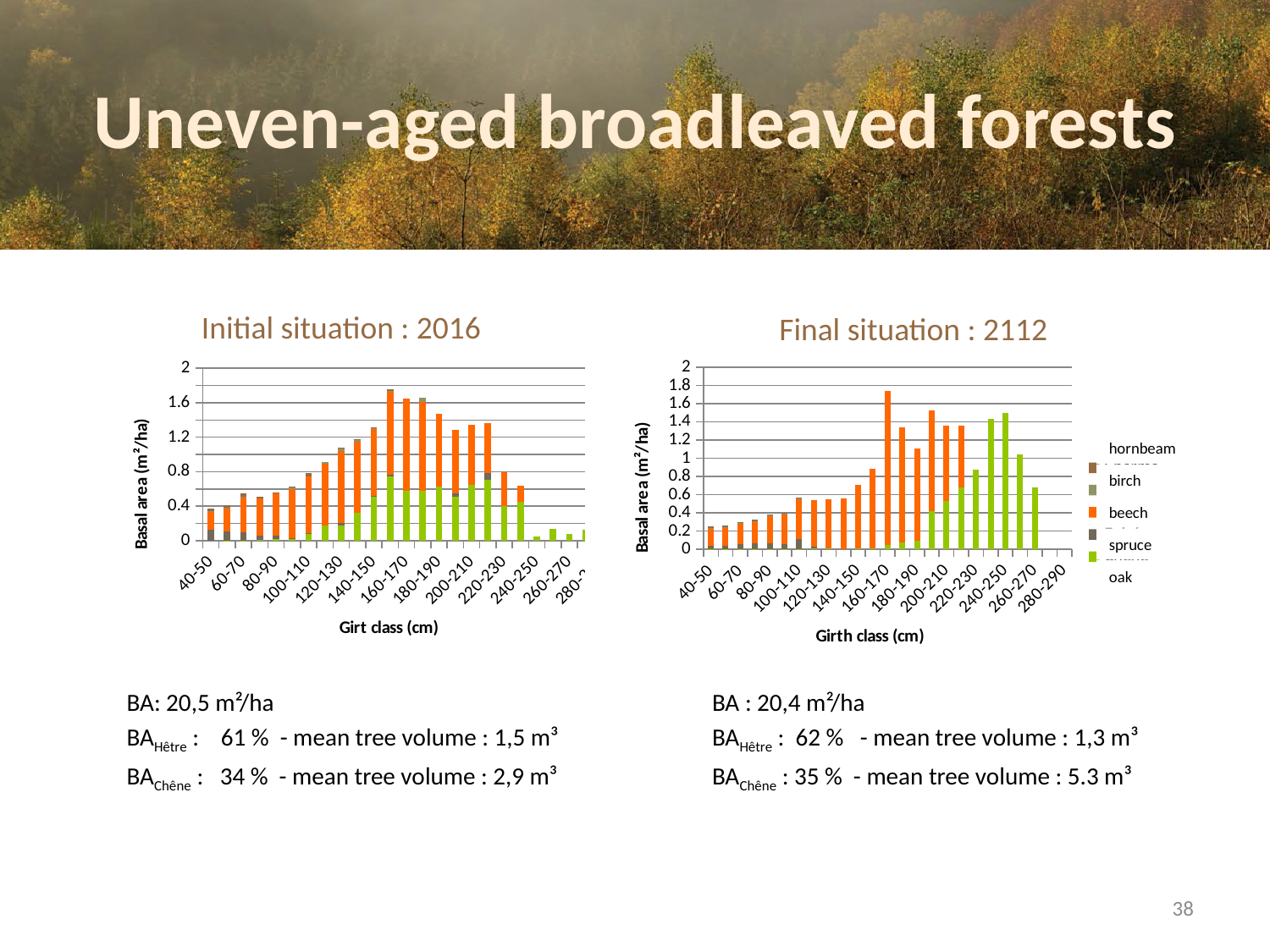
What kind of chart is the 'Initial situation : 2016' chart? bar chart In the 'Final situation : 2112' chart, is the total value for the 240-250 girth class greater or less than 1.2? greater How many series does the legend of the 'Final situation : 2112' chart list? 5 In the 'Initial situation : 2016' chart, is the total value for the 160-170 girth class greater or less than 1.2? greater In the 'Initial situation : 2016' chart, is the total value for the 260-270 girth class greater or less than 0.4? less What is the y-axis label of the 'Final situation : 2112' chart? Basal area (m²/ha) In the 'Final situation : 2112' chart, which girth class has the highest total basal area? 160-170 In the 'Initial situation : 2016' chart, do the total values rise or fall from the 40-50 girth class to the 160-170 girth class? rise In the 'Final situation : 2112' chart, which has the larger total basal area, the 160-170 girth class or the 280-290 girth class? 160-170 In the 'Initial situation : 2016' chart, which has the larger total basal area, the 40-50 girth class or the 160-170 girth class? 160-170